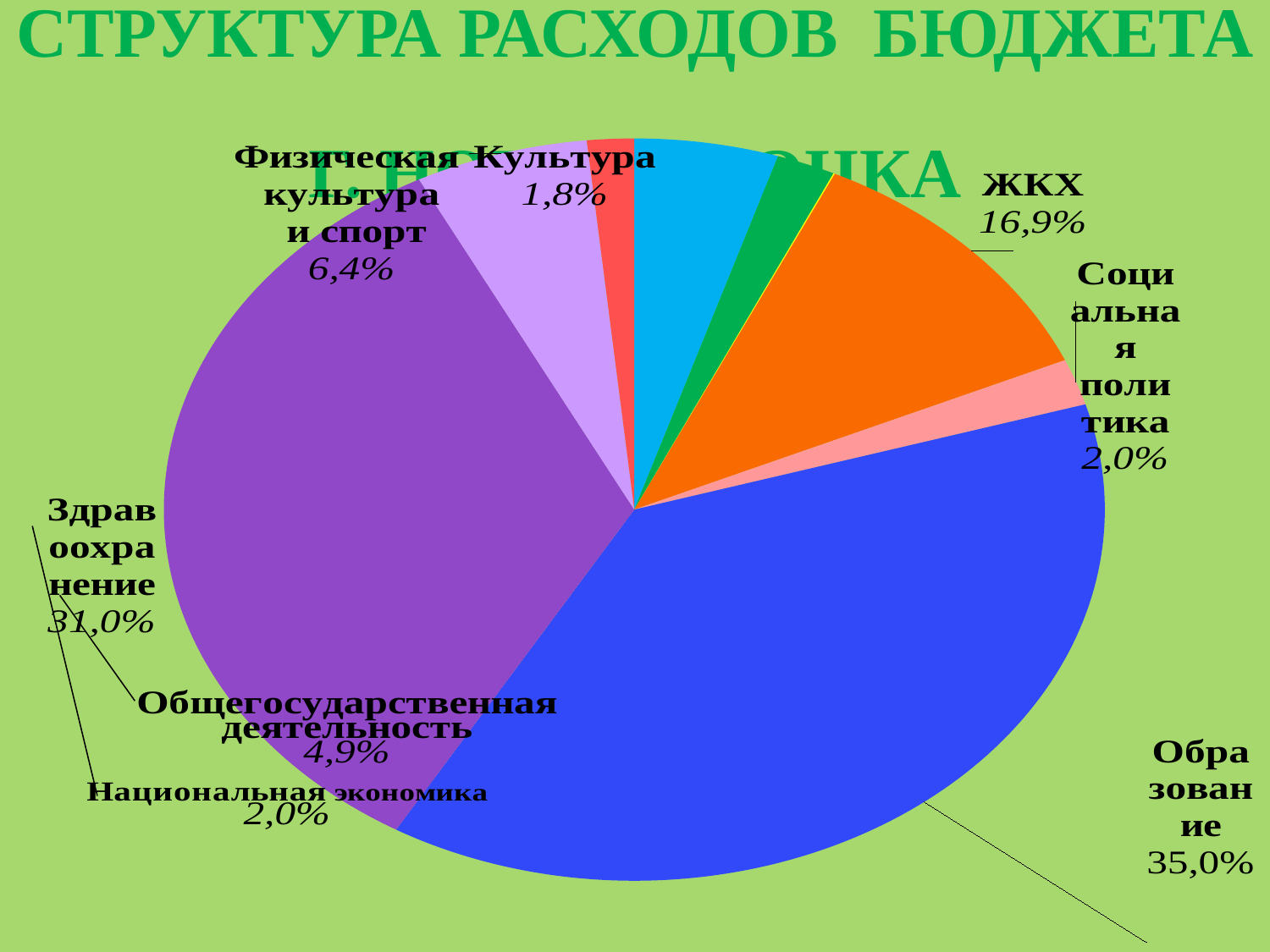
What share of budget expenditure goes to Здравоохранение? 31,0% Which category has the smallest share of budget expenditure? Культура What share of budget expenditure goes to ЖКХ? 16,9% What share of budget expenditure goes to Общегосударственная деятельность? 4,9% What share of budget expenditure goes to Физическая культура и спорт? 6,4% What kind of chart is shown on the slide? pie chart What share of budget expenditure goes to Культура? 1,8% Which has a larger share, ЖКХ or Физическая культура и спорт? ЖКХ What is the difference between the shares of Образование and Здравоохранение? 4,0% Which category has the largest share of budget expenditure? Образование How many categories are shown in the pie chart? 8 What share of budget expenditure goes to Образование? 35,0%